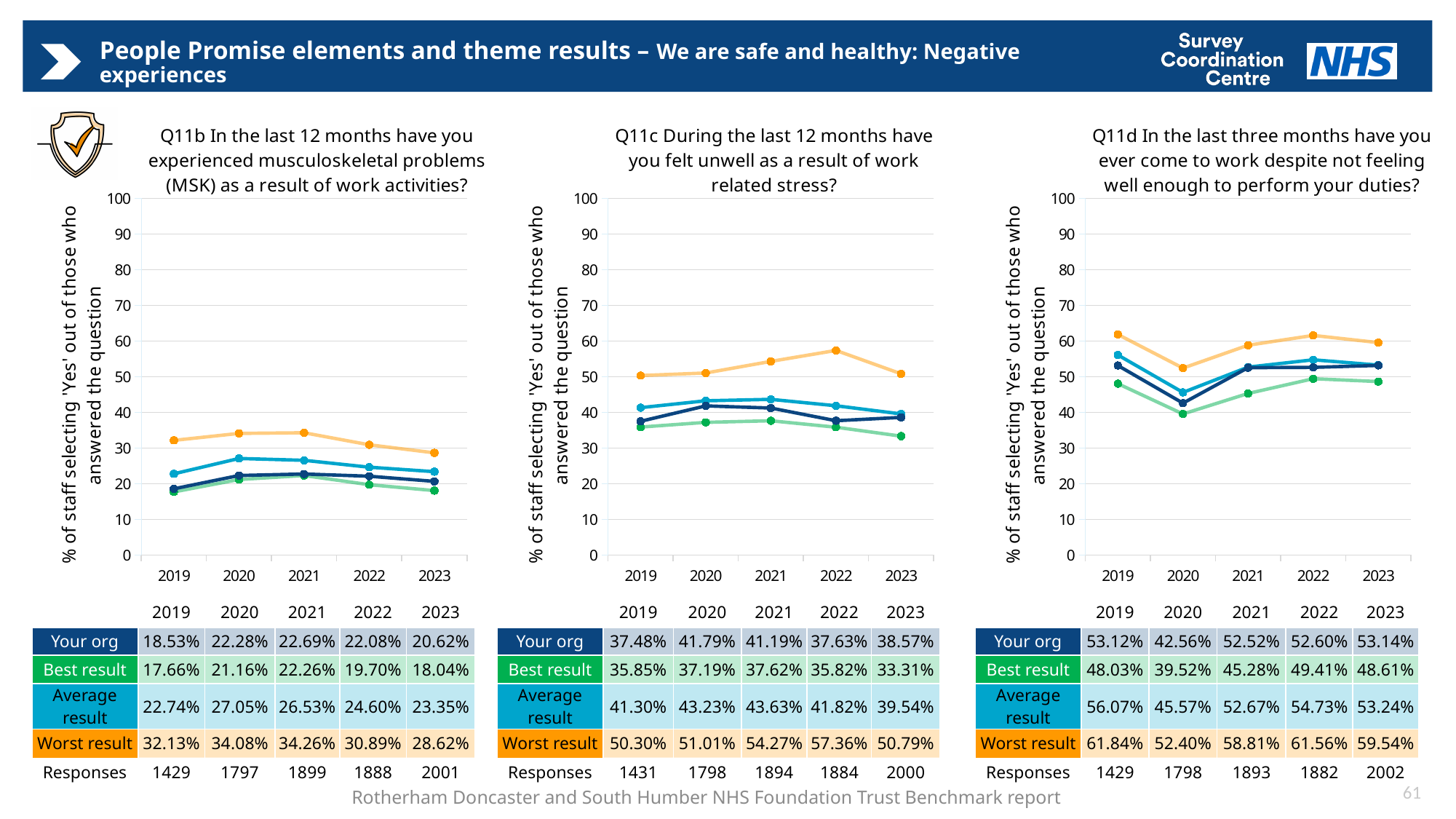
In the Q11c chart (middle), in which year is the 'Best result' value lowest? 2023 In the Q11b chart (left), in which year is the 'Worst result' value highest? 2021 In the Q11d chart (right), is the 'Worst result' value for 2019 greater or less than 60? greater In the Q11c chart (middle), what is the 'Worst result' value for 2022? 57.36% In the Q11d chart (right), what is the 'Your org' value for 2020? 42.56% How many series (lines) are plotted in the Q11c chart (middle)? 4 In the Q11c chart (middle), what is the difference between the 'Worst result' and 'Your org' values for 2022? 19.73 percentage points In the Q11b chart (left), does the 'Worst result' line rise or fall from 2021 to 2023? Fall In the Q11b chart (left), what is the 'Your org' value for 2023? 20.62% What type of chart is used for Q11d (right)? Line chart How many years are plotted on the x axis of the Q11b chart (left)? 5 In the Q11d chart (right), which is larger in 2021: 'Your org' or 'Average result'? Average result